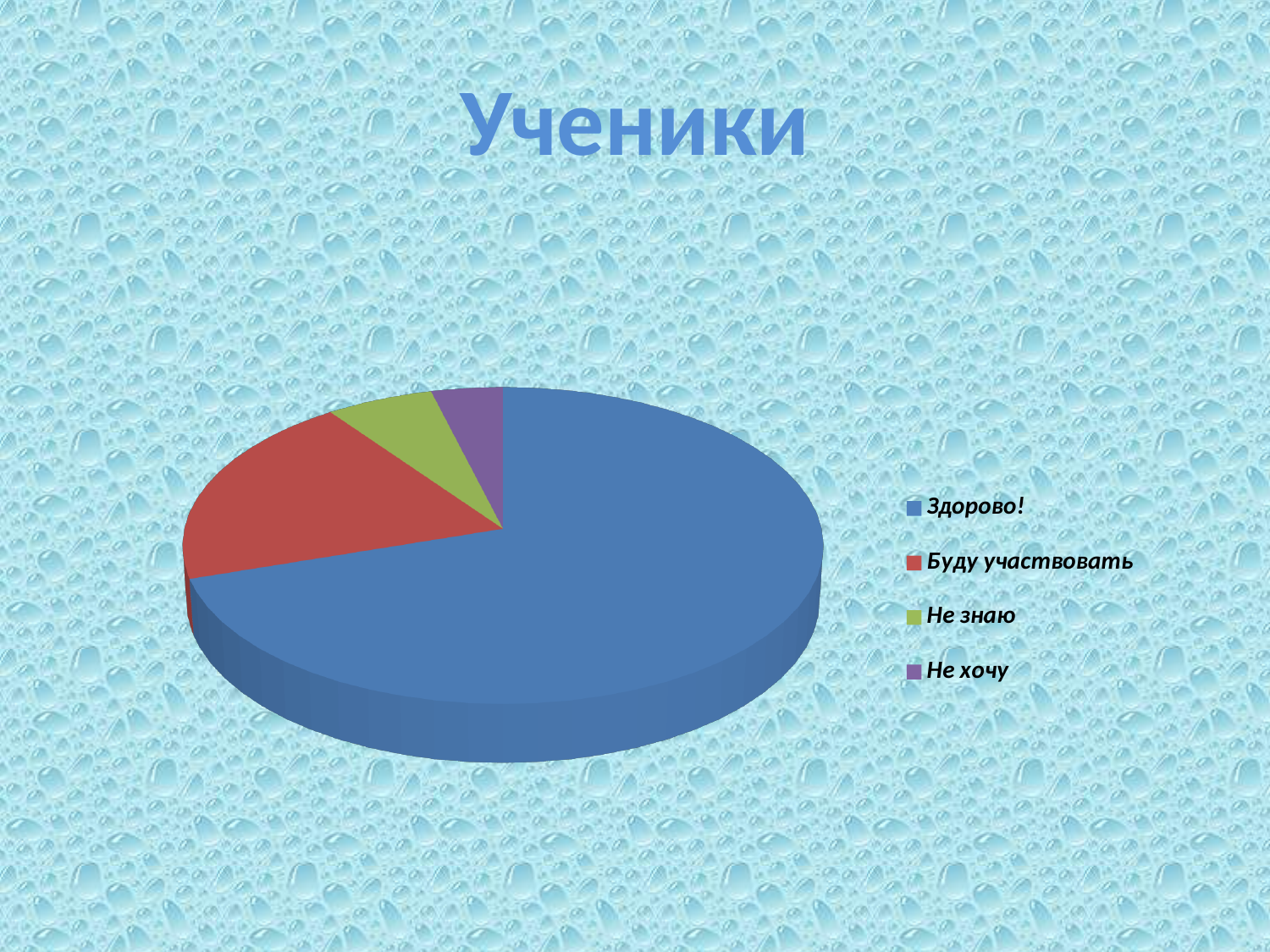
Which category is shown in blue in the pie chart? Здорово! Which category has the second-largest slice of the pie? Буду участвовать Which slice is larger: Не знаю or Не хочу? Не знаю How many categories (slices) does the pie chart have? 4 How many entries does the legend list? 4 What is the title of the chart on the slide? Ученики Which slice is larger: Здорово! or Буду участвовать? Здорово! What kind of chart is shown on the slide? pie chart Which category has the smallest slice of the pie? Не хочу Which slice is larger: Буду участвовать or Не знаю? Буду участвовать Which category has the largest slice of the pie? Здорово!